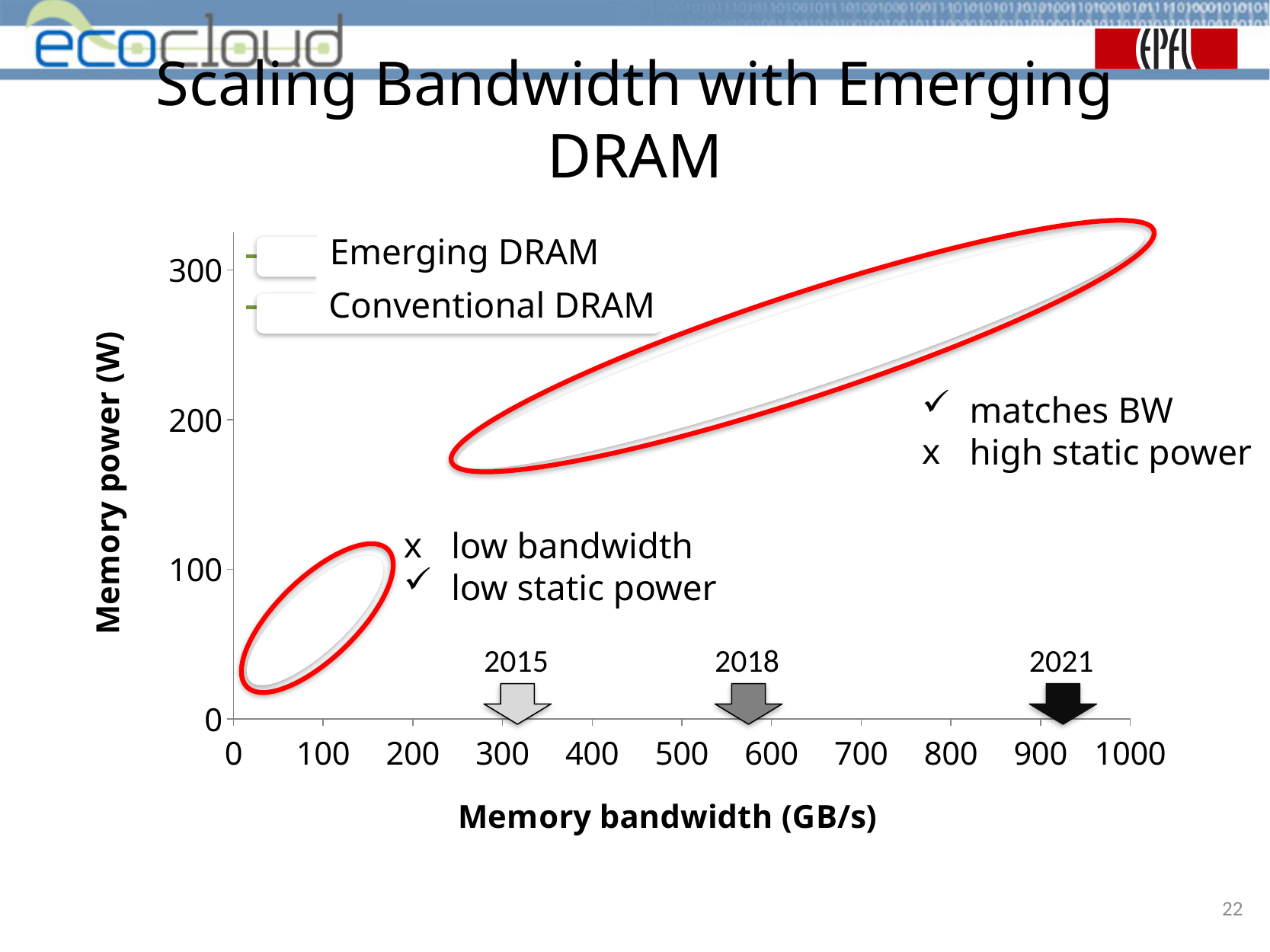
Which series, Emerging DRAM or Conventional DRAM, reaches the higher memory bandwidth? Emerging DRAM What are the two series named in the chart legend? Emerging DRAM and Conventional DRAM Which year marker is placed at the lowest memory bandwidth on the x axis? 2015 How many series does the chart legend list? 2 Which year marker is placed at the highest memory bandwidth on the x axis? 2021 What is the label of the chart's x axis? Memory bandwidth (GB/s) How many year markers (arrows) are shown along the x axis? 3 Which series, Emerging DRAM or Conventional DRAM, reaches the higher memory power? Emerging DRAM As memory bandwidth increases along the x axis, does memory power rise or fall? rise